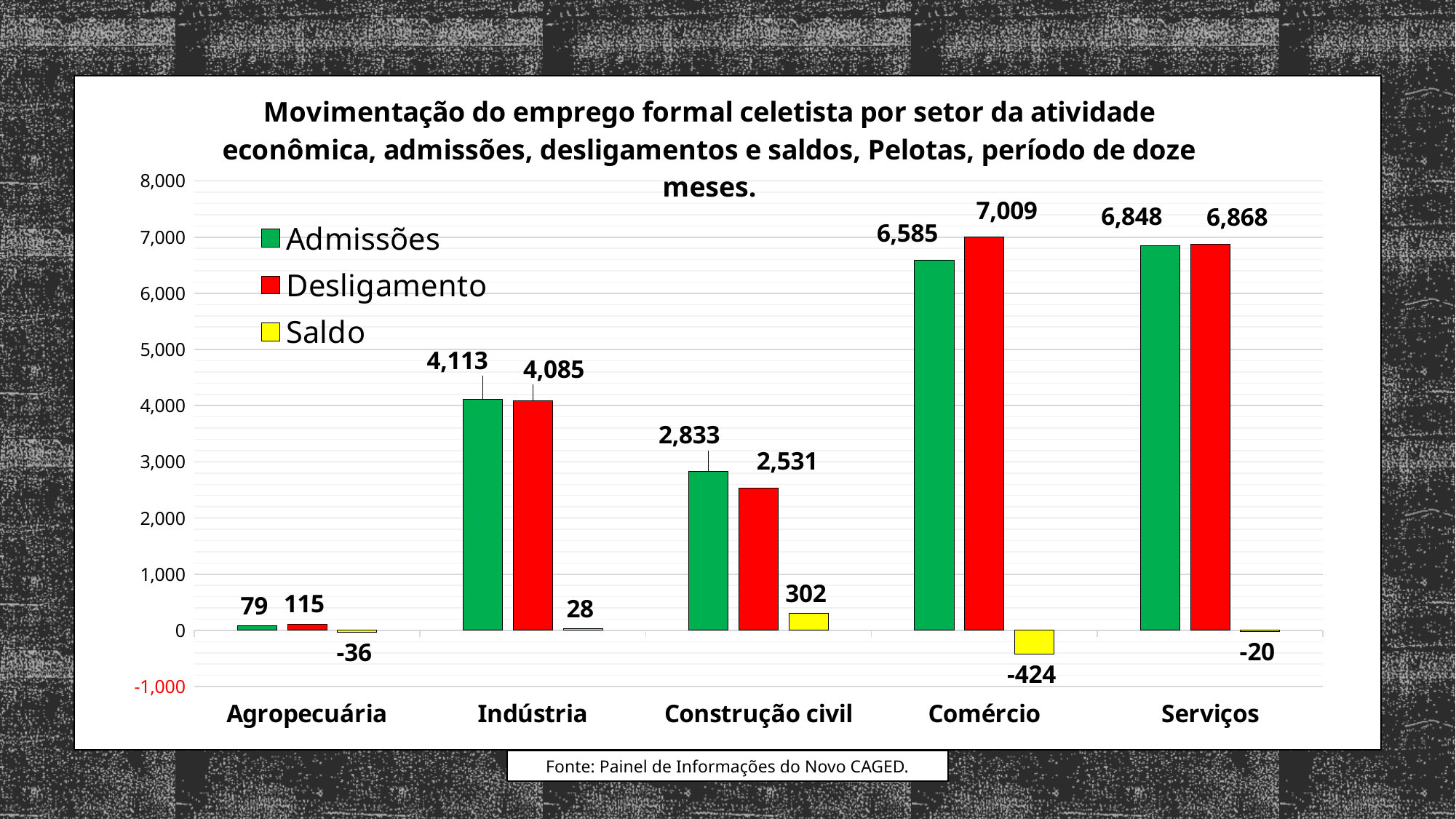
Which sector has the lowest Desligamento value? Agropecuária What kind of chart is shown on the slide? bar chart What is the Saldo value for Comércio? -424 What is the difference between Admissões and Desligamento for Construção civil? 302 How many series does the legend list? 3 How many sectors are shown on the x axis? 5 What is the Saldo value for Construção civil? 302 Which is larger for Comércio, Admissões or Desligamento? Desligamento Is the Admissões value for Indústria greater or less than 5,000? less Which sector has the highest Admissões value? Serviços What is the Admissões value for Comércio? 6,585 What is the Desligamento value for Indústria? 4,085